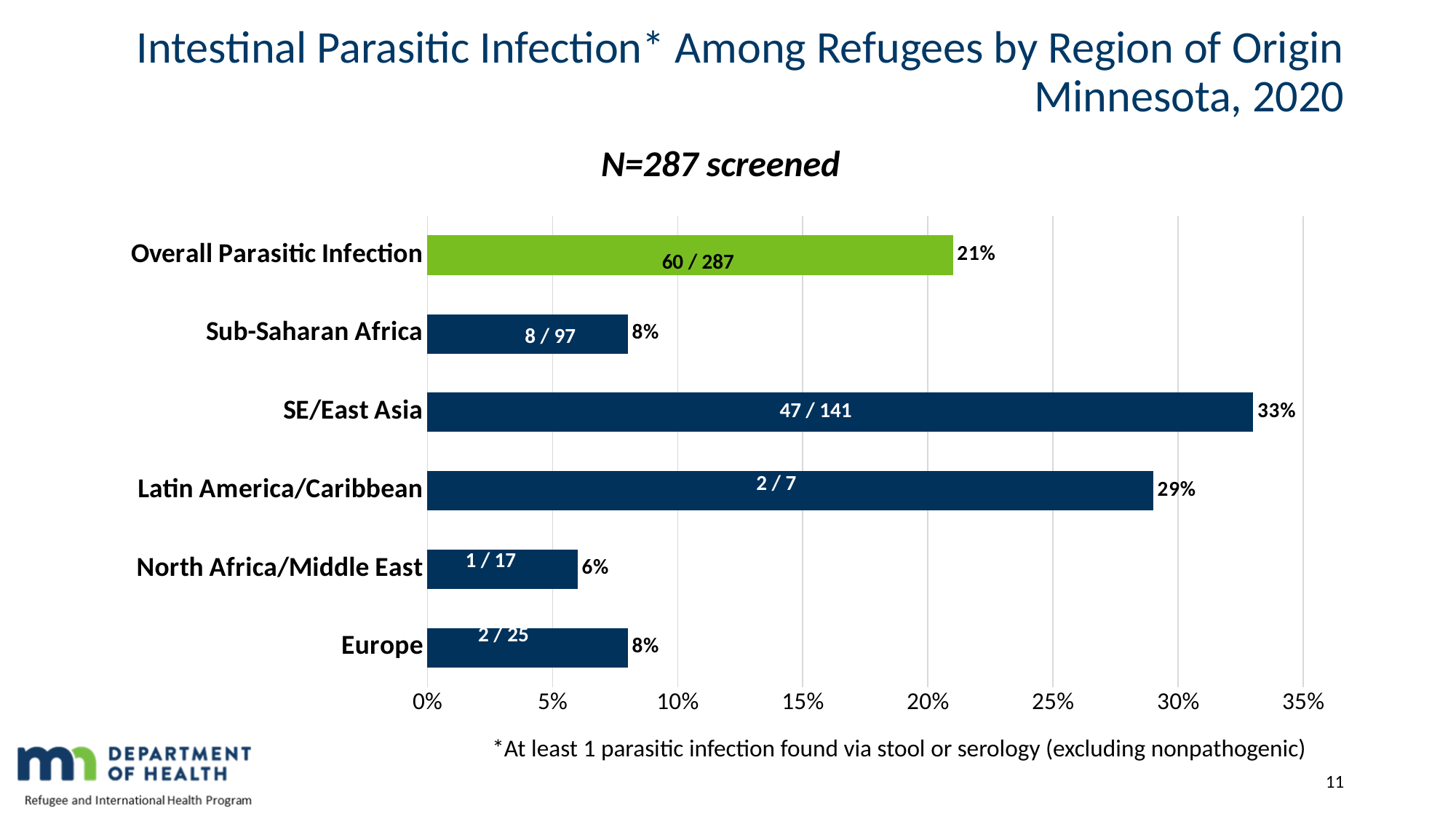
What is the percentage for North Africa/Middle East? 6% What type of chart is shown on the slide? Bar chart Which is larger, the percentage for Sub-Saharan Africa or for North Africa/Middle East? Sub-Saharan Africa How many bars are shown in the chart? 6 Which bar is shown in green rather than dark blue? Overall Parasitic Infection What fraction is shown inside the bar for Latin America/Caribbean? 2 / 7 What is the percentage for SE/East Asia? 33% What is the percentage for Overall Parasitic Infection? 21% Which region has the highest percentage of parasitic infection? SE/East Asia Is the value for Latin America/Caribbean greater or less than 25%? greater What is the difference in percentage points between SE/East Asia and Latin America/Caribbean? 4 Which category has the lowest percentage? North Africa/Middle East